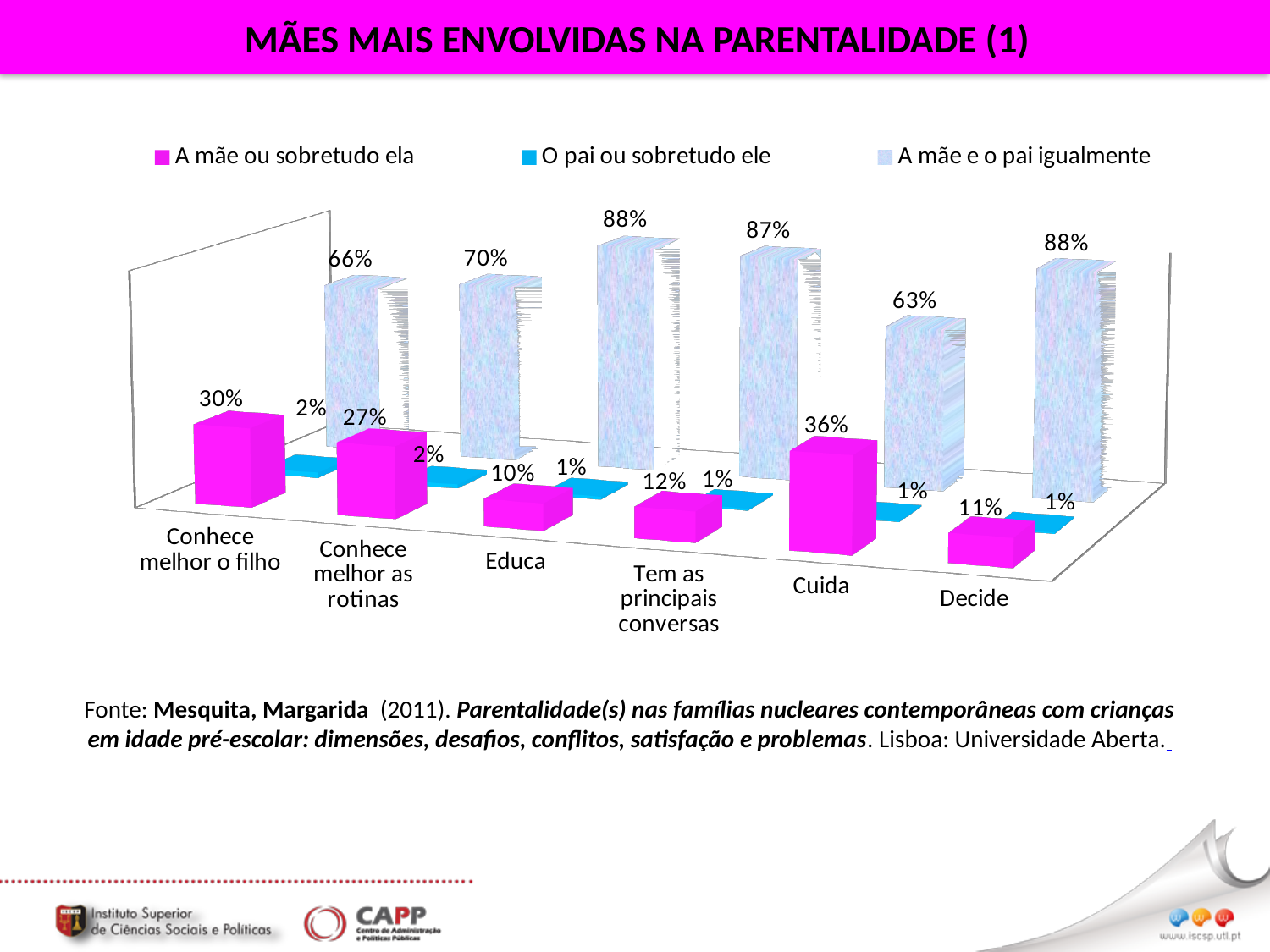
Which category has the highest value in the series 'A mãe ou sobretudo ela'? Cuida What kind of chart is shown on the slide? Bar chart What is the value for 'Conhece melhor o filho' in the series 'O pai ou sobretudo ele'? 2% What is the value for 'Decide' in the series 'A mãe ou sobretudo ela'? 11% Which is larger: the 'A mãe ou sobretudo ela' value for 'Conhece melhor o filho' or for 'Conhece melhor as rotinas'? Conhece melhor o filho What is the value for 'Educa' in the series 'A mãe e o pai igualmente'? 88% How many categories are shown on the x axis? 6 How many series does the legend list? 3 Which category has the lowest value in the series 'A mãe ou sobretudo ela'? Educa Which category has the lowest value in the series 'A mãe e o pai igualmente'? Cuida What is the difference between the 'A mãe e o pai igualmente' values for 'Conhece melhor as rotinas' and 'Conhece melhor o filho'? 4% What is the value for 'Cuida' in the series 'A mãe ou sobretudo ela'? 36%